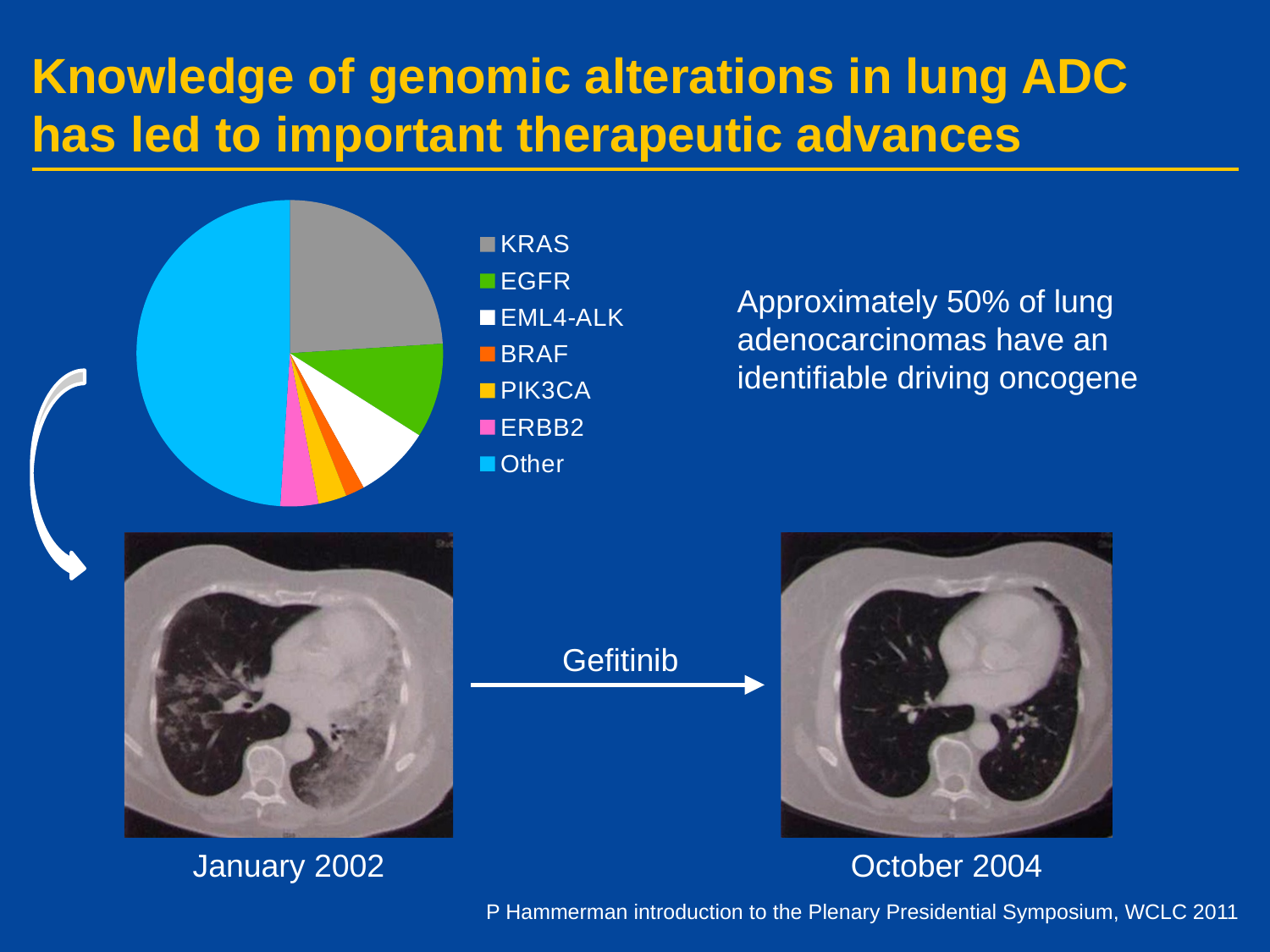
Which is larger in the pie chart, the KRAS slice or the PIK3CA slice? KRAS How many categories does the pie chart show? 7 Which is larger in the pie chart, the KRAS slice or the EGFR slice? KRAS What kind of chart is shown on the slide? pie chart Which category in the pie chart legend is shown in green? EGFR Which is larger in the pie chart, the Other slice or the KRAS slice? Other Which category has the largest slice of the pie chart? Other What colour is the Other slice in the pie chart? light blue How many entries does the pie chart's legend list? 7